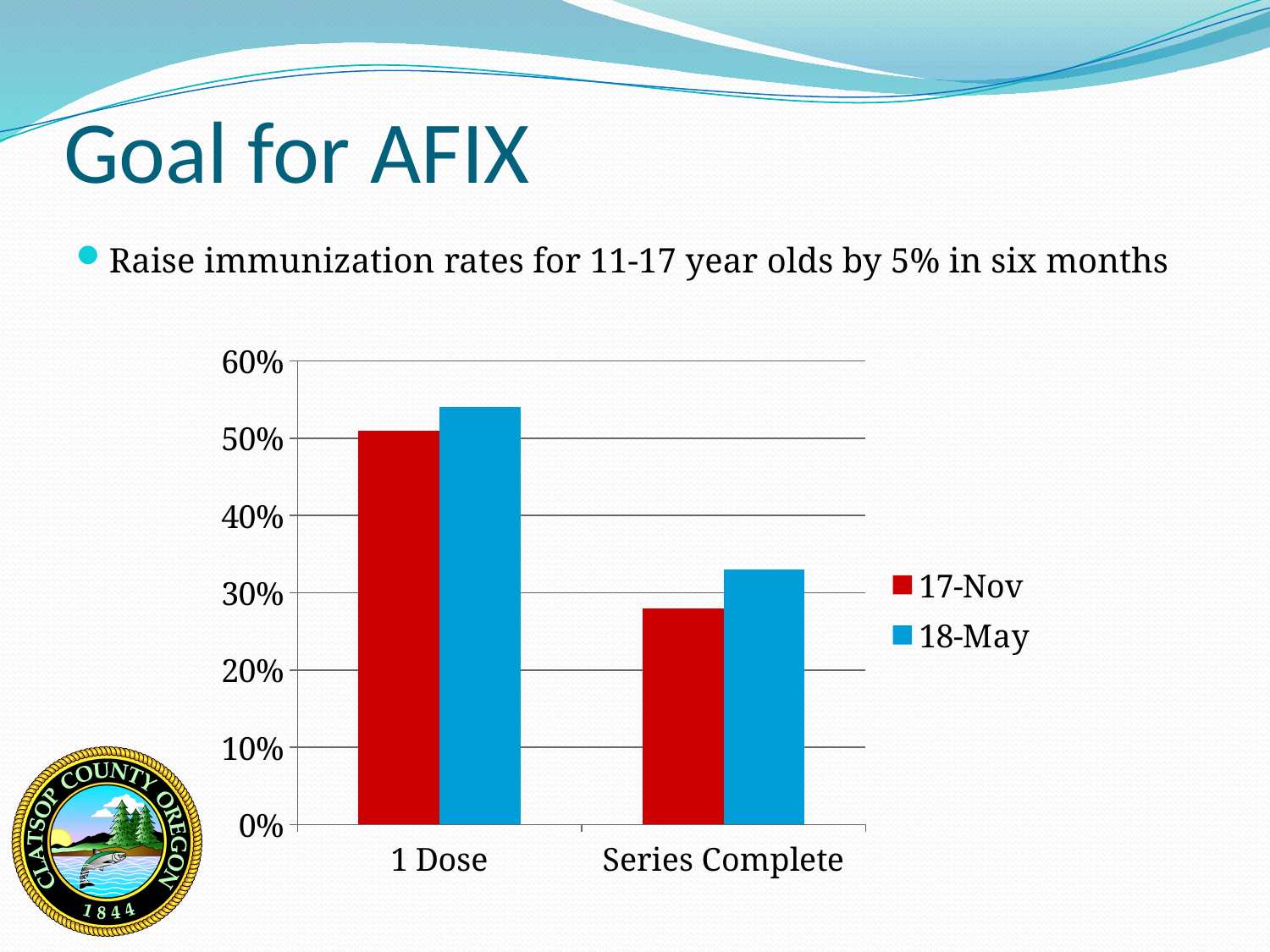
Which series is shown in red in the chart? 17-Nov Is the 18-May value for Series Complete greater or less than 40%? less Is the 18-May value for 1 Dose greater or less than 50%? greater Which category has the lowest bar in the chart? Series Complete What kind of chart is shown on the slide? bar chart Is the 17-Nov value for 1 Dose greater or less than 40%? greater How many categories are shown on the x axis of the chart? 2 Which series is shown in blue in the chart? 18-May For Series Complete, which series has the larger value, 17-Nov or 18-May? 18-May How many series does the chart legend list? 2 For 1 Dose, which series has the larger value, 17-Nov or 18-May? 18-May